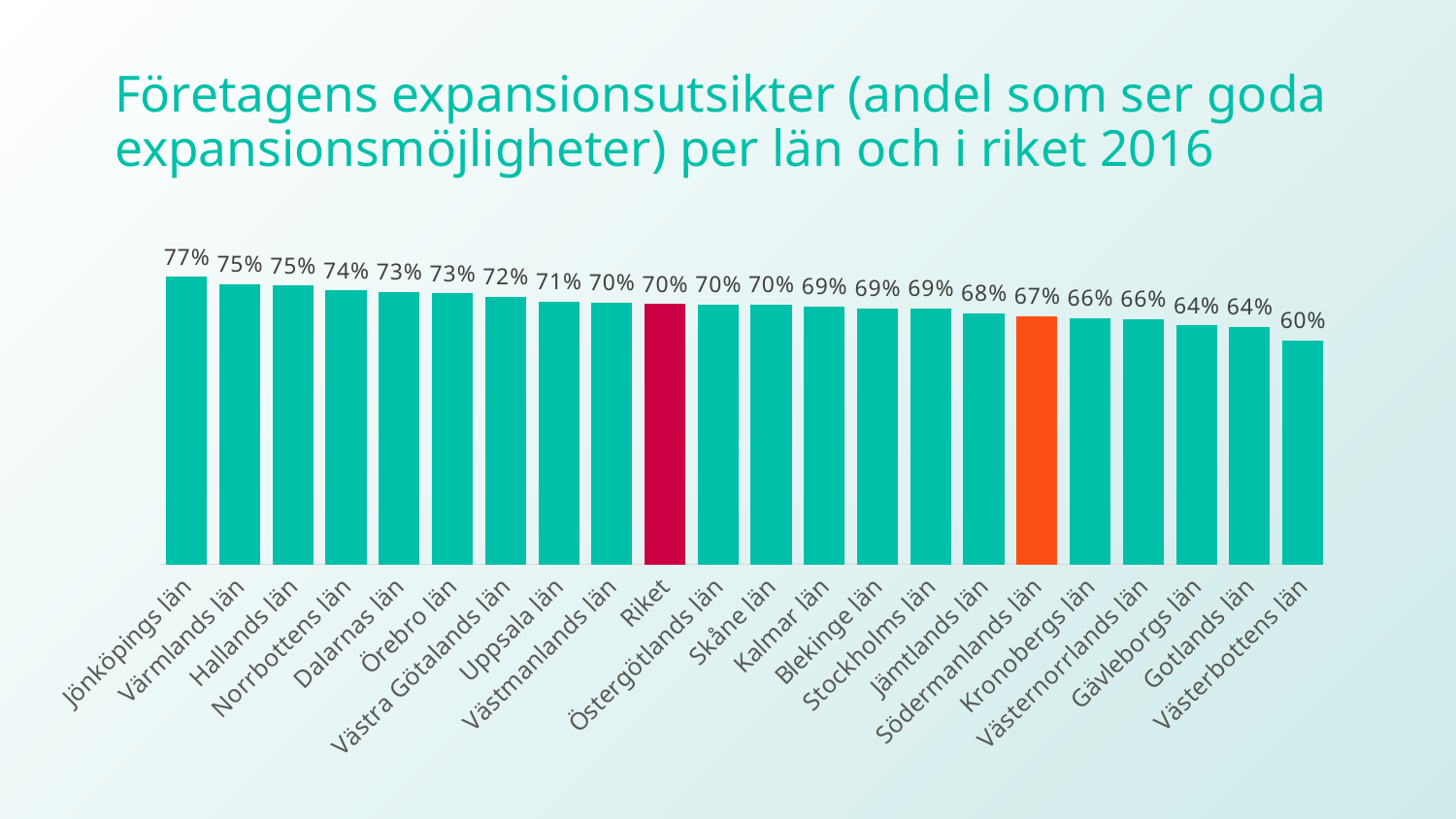
Which category has the highest value? Jönköpings län How many bars are shown in the chart? 22 Which category has the lowest value? Västerbottens län Which is larger, the value for Norrbottens län or the value for Gotlands län? Norrbottens län Do the values rise or fall from left to right along the x axis? Fall What kind of chart is shown on the slide? Bar chart What is the value for Södermanlands län? 67% What is the value for Riket? 70% What is the value for Stockholms län? 69% What is the value for Jönköpings län? 77% What is the difference between the values for Jönköpings län and Västerbottens län? 17 percentage points Which bar is coloured red in the chart? Riket